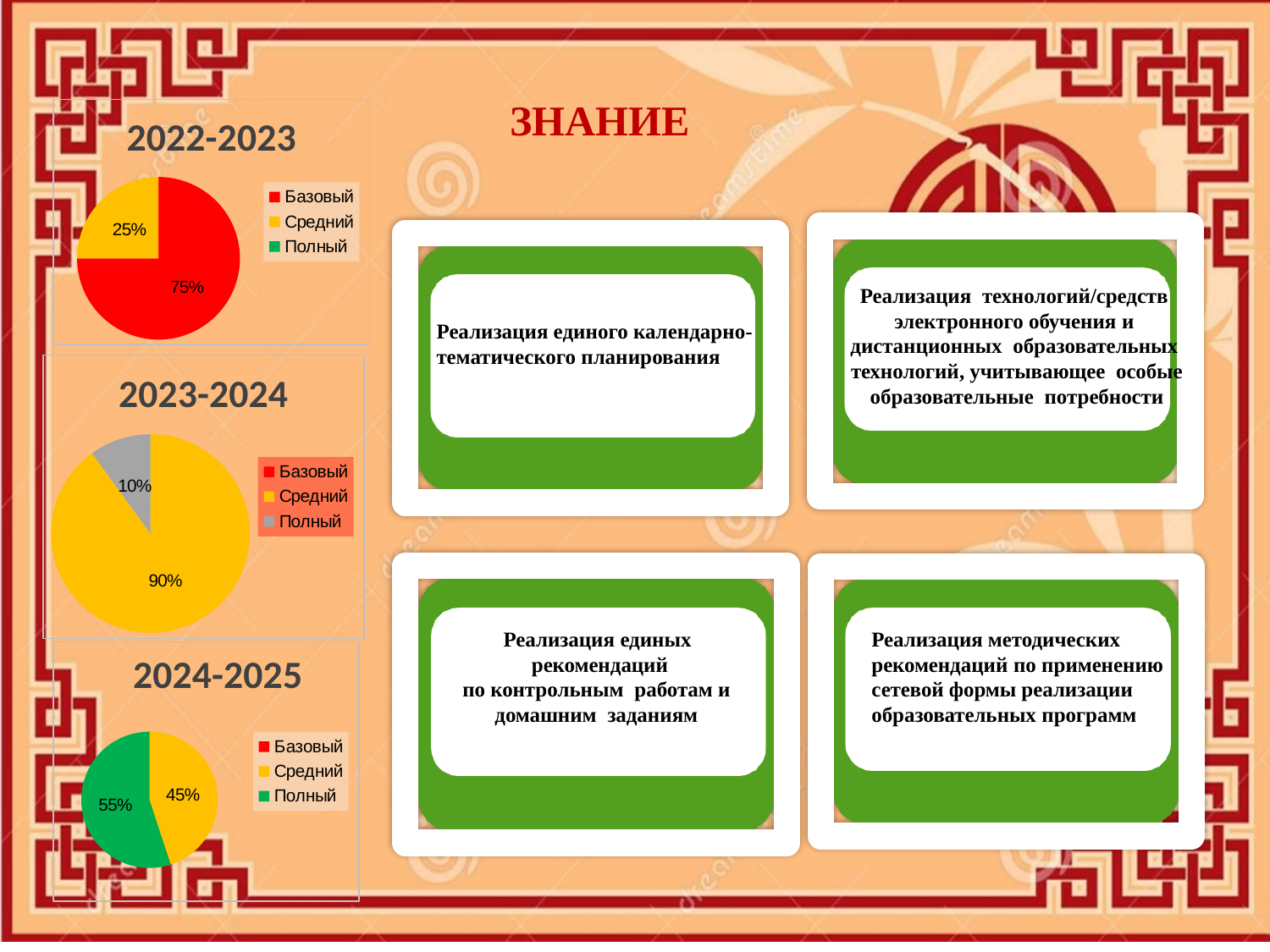
In the 2022-2023 chart, which category has the largest slice? Базовый How many entries does the legend of the 2022-2023 chart list? 3 In the 2022-2023 chart, what is the difference between the Базовый and Средний shares? 50% In the 2023-2024 chart, what share is labelled for Полный? 10% In the 2023-2024 chart, which is larger, Средний or Полный? Средний In the 2022-2023 chart, what share is labelled for Средний? 25% In the 2024-2025 chart, what is the difference between the Полный and Средний shares? 10% In the 2022-2023 chart, what share is labelled for Базовый? 75% In the 2024-2025 chart, what share is labelled for Средний? 45% In the 2024-2025 chart, what share is labelled for Полный? 55% What type of chart is the 2024-2025 chart? Pie chart In the 2023-2024 chart, what share is labelled for Средний? 90%